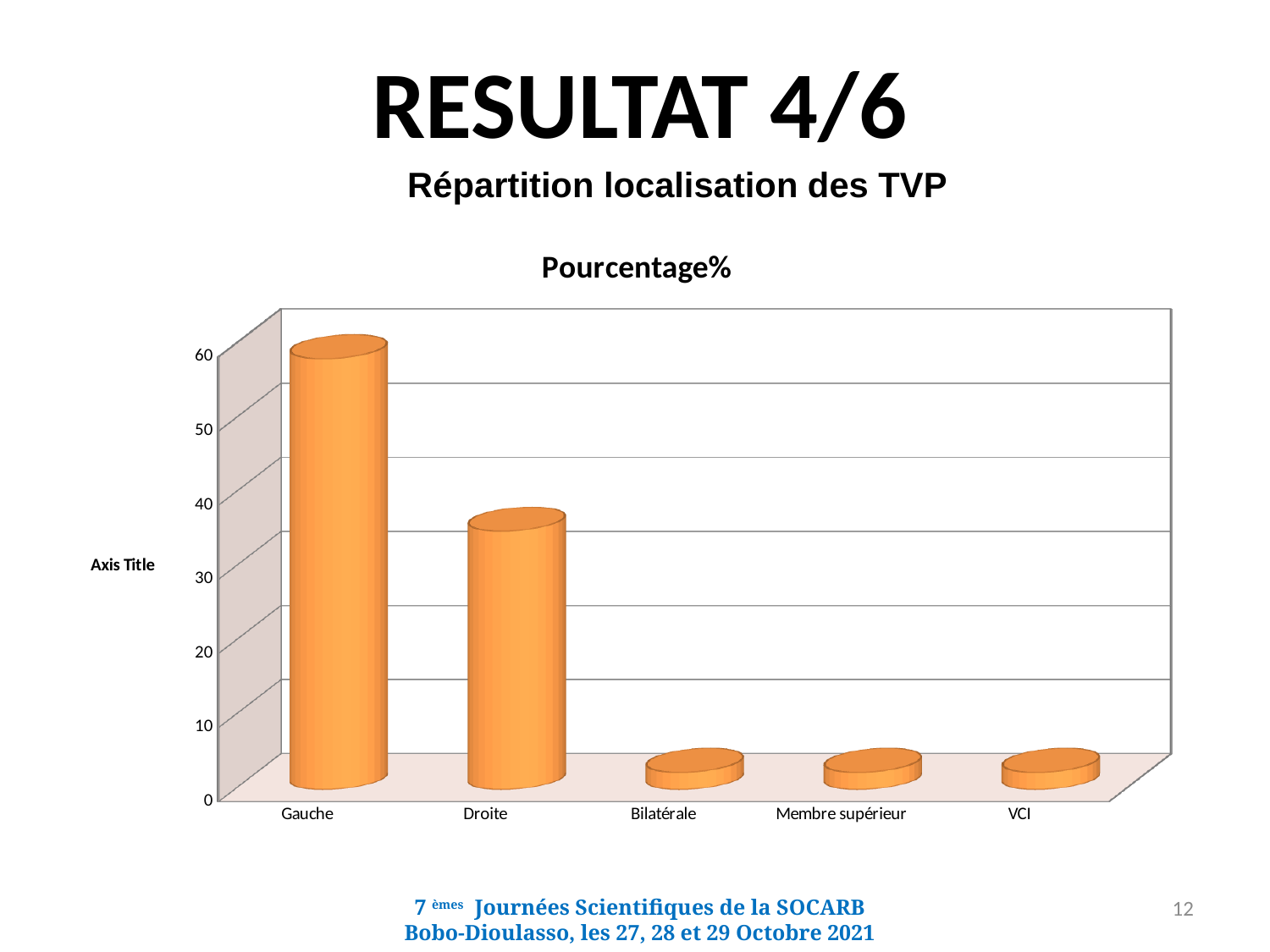
Is the value for Gauche greater or less than 50? greater Is the value for Bilatérale greater or less than 10? less How many categories are shown on the x axis of the chart? 5 Is the value for Membre supérieur greater or less than 10? less Which category has the highest value in the chart? Gauche What is the title of the chart? Pourcentage% Do the values generally rise or fall moving along the x axis from Gauche to VCI? fall Which is larger, the value for Gauche or the value for Droite? Gauche What type of chart is shown on the slide? Bar chart